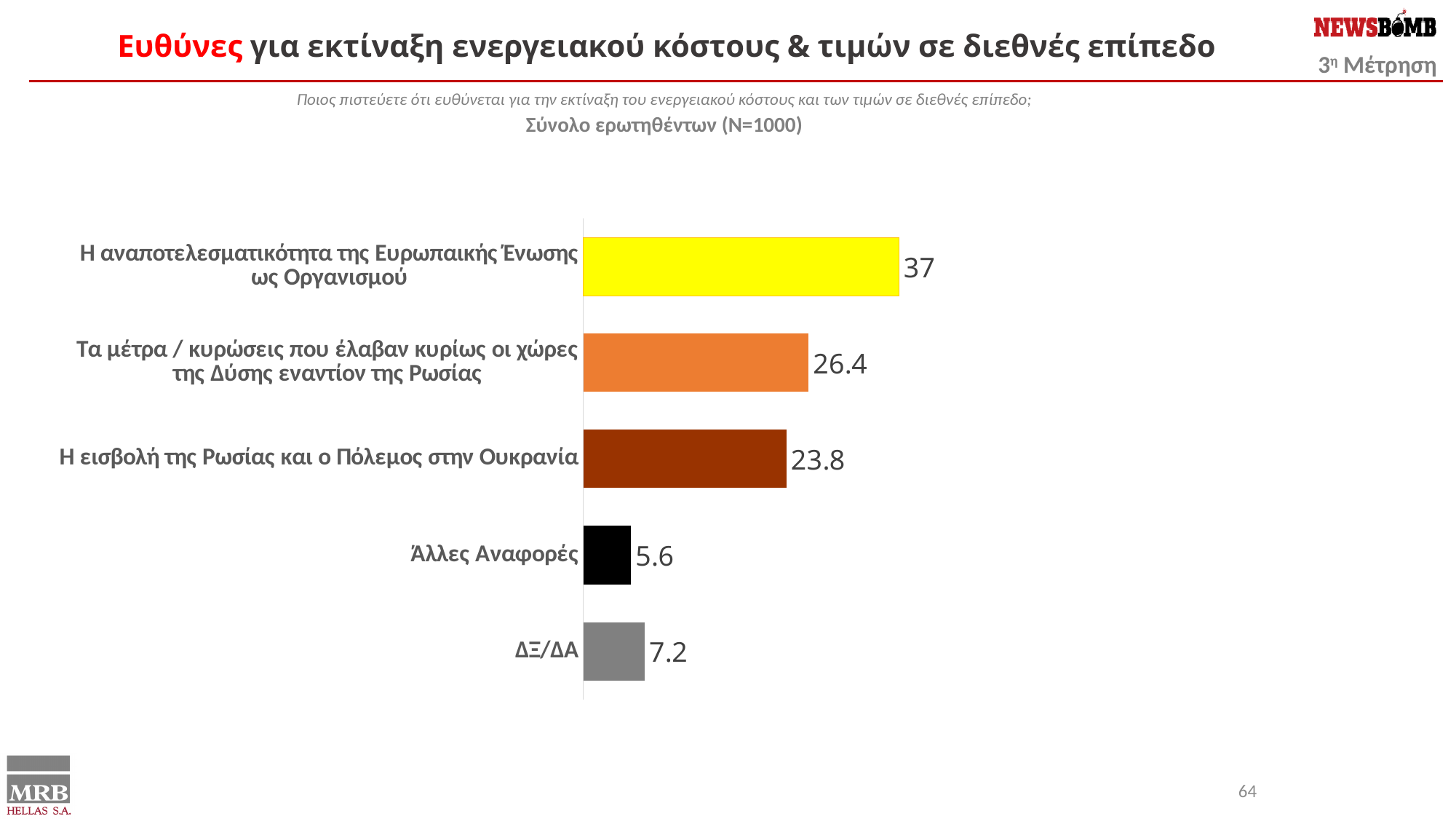
What is the sample size (N) stated above the chart? N=1000 Which category has the lowest value? Άλλες Αναφορές Which category has the highest value? Η αναποτελεσματικότητα της Ευρωπαικής Ένωσης ως Οργανισμού What is the value for 'Τα μέτρα / κυρώσεις που έλαβαν κυρίως οι χώρες της Δύσης εναντίον της Ρωσίας'? 26.4 Which is larger: the value for 'ΔΞ/ΔΑ' or the value for 'Άλλες Αναφορές'? ΔΞ/ΔΑ What is the difference between the values for 'Τα μέτρα / κυρώσεις που έλαβαν κυρίως οι χώρες της Δύσης εναντίον της Ρωσίας' and 'Η εισβολή της Ρωσίας και ο Πόλεμος στην Ουκρανία'? 2.6 How many categories are shown in the chart? 5 What is the value for 'Άλλες Αναφορές'? 5.6 What is the value for 'Η αναποτελεσματικότητα της Ευρωπαικής Ένωσης ως Οργανισμού'? 37 What is the value for 'ΔΞ/ΔΑ'? 7.2 What kind of chart is shown on the slide? Bar chart What is the value for 'Η εισβολή της Ρωσίας και ο Πόλεμος στην Ουκρανία'? 23.8